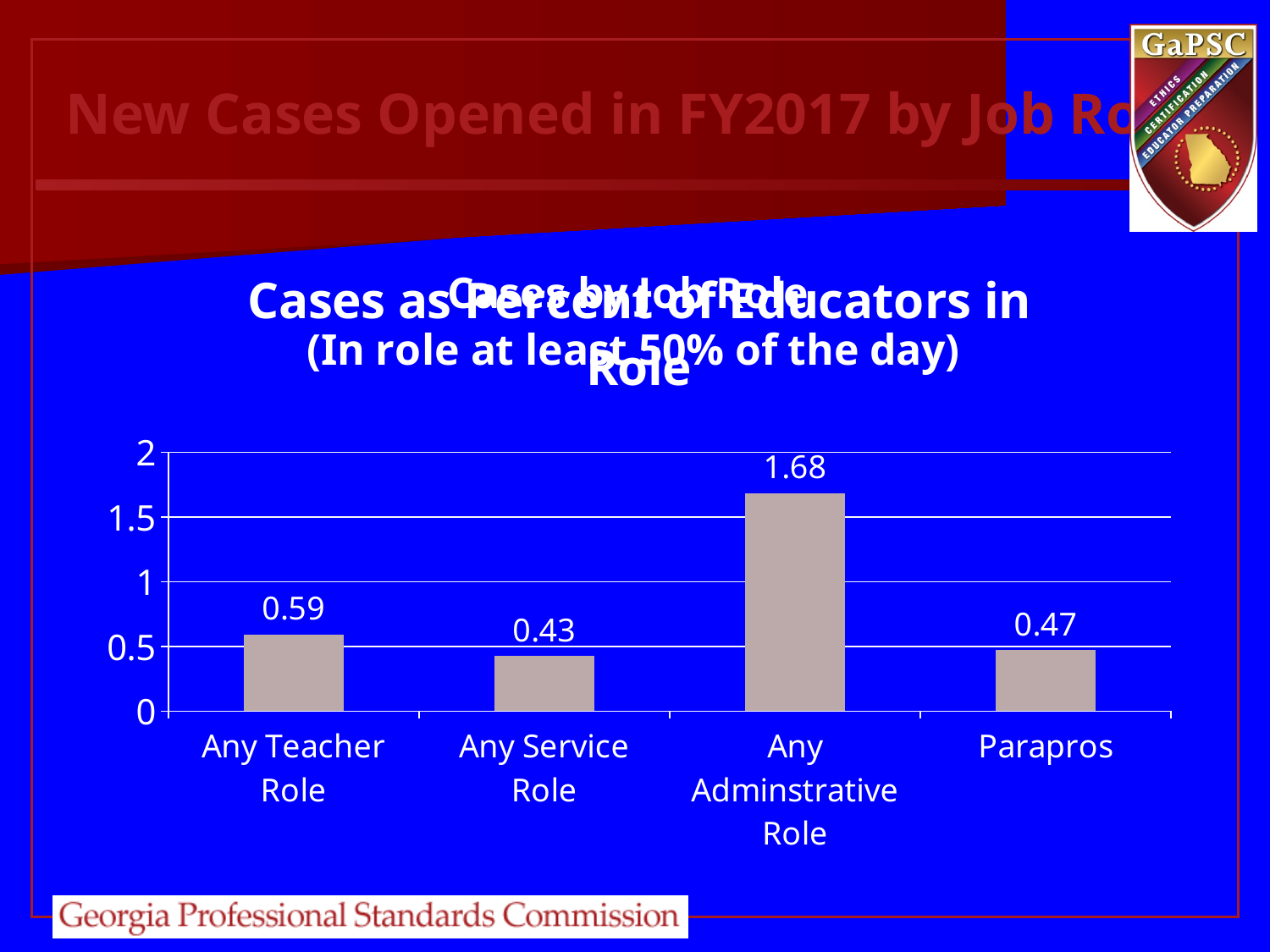
What is the value for Any Teacher Role? 0.59 How many job role categories are shown on the chart? 4 What kind of chart is shown on the slide? bar chart What is the difference between the values for Any Teacher Role and Any Service Role? 0.16 Is the value for Any Adminstrative Role greater or less than 1.5? greater Which job role has the highest value? Any Adminstrative Role What is the value for Parapros? 0.47 What is the value for Any Adminstrative Role? 1.68 What is the value for Any Service Role? 0.43 What is the difference between the values for Any Adminstrative Role and Any Teacher Role? 1.09 Which is larger, the value for Any Teacher Role or the value for Parapros? Any Teacher Role Which job role has the lowest value? Any Service Role